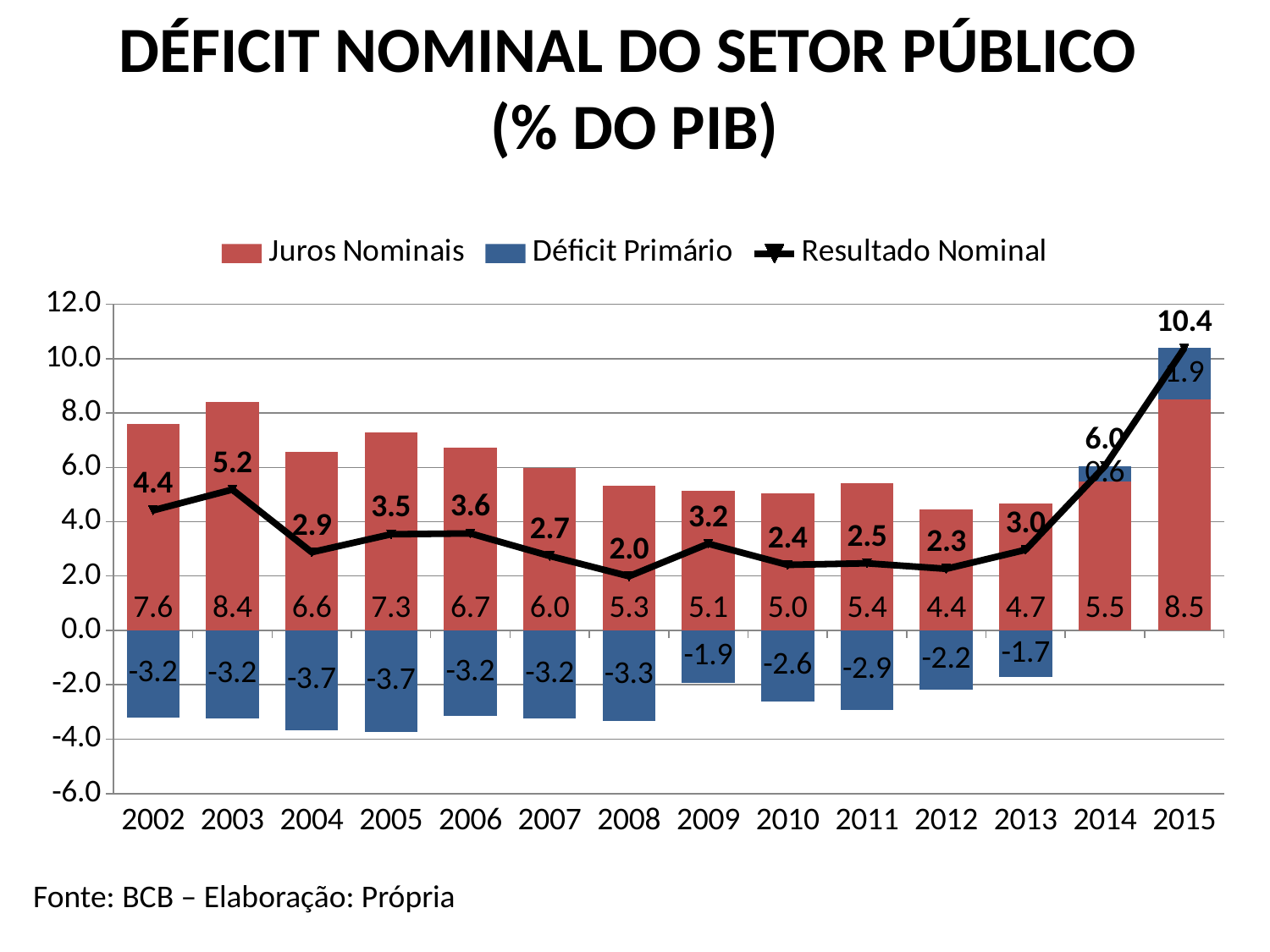
Which year has the lowest Resultado Nominal value? 2008 What is the difference between the Juros Nominais values for 2015 and 2014? 3.0 How many series does the legend list? 3 What is the Resultado Nominal value for 2015? 10.4 Which is larger, the Resultado Nominal value for 2002 or for 2003? 2003 Which year has the lowest Juros Nominais value? 2012 How many years are shown on the x axis? 14 What is the Juros Nominais value for 2003? 8.4 What is the Déficit Primário value for 2009? -1.9 Does the Resultado Nominal line rise or fall from 2013 to 2015? Rise What kind of chart is this? Stacked bar chart with a line Which year has the highest Resultado Nominal value? 2015